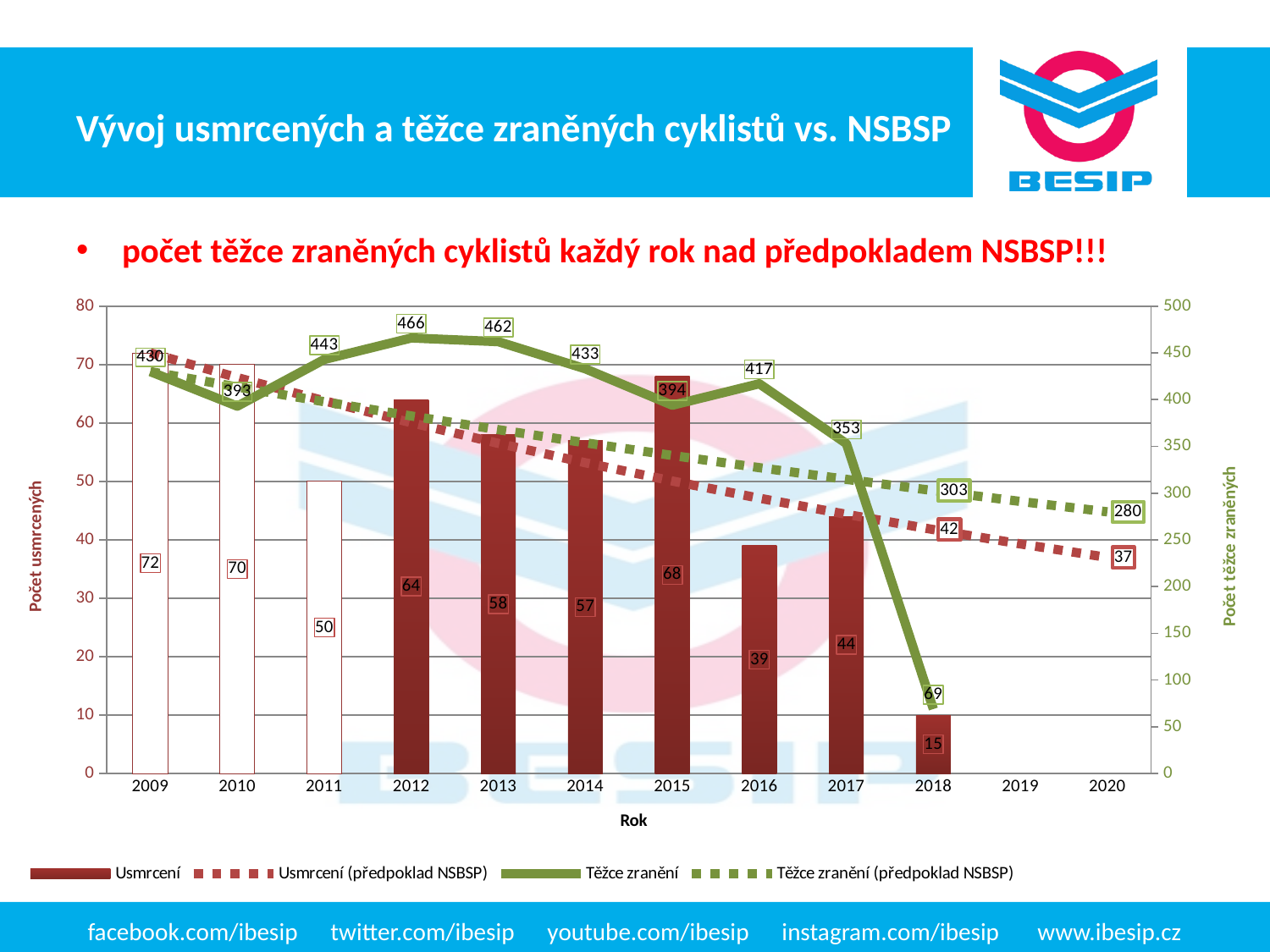
What is the value of Těžce zranění (seriously injured) for 2013? 462 What is the label of the left vertical axis? Počet usmrcených How many series does the legend list? 4 Does the Těžce zranění line rise or fall between 2017 and 2018? fall Which is larger, the Těžce zranění value for 2016 or for 2017? 2016 Which year has the highest Těžce zranění value? 2012 What is the Těžce zranění (předpoklad NSBSP) value shown for 2020? 280 What is the difference between the Usmrcení values for 2009 and 2018? 57 How many cyclists were killed (Usmrcení) in 2012 according to the chart? 64 What is the Usmrcení (předpoklad NSBSP) value shown for 2020? 37 What is the Usmrcení value for 2018? 15 Which year has the lowest Usmrcení value? 2018